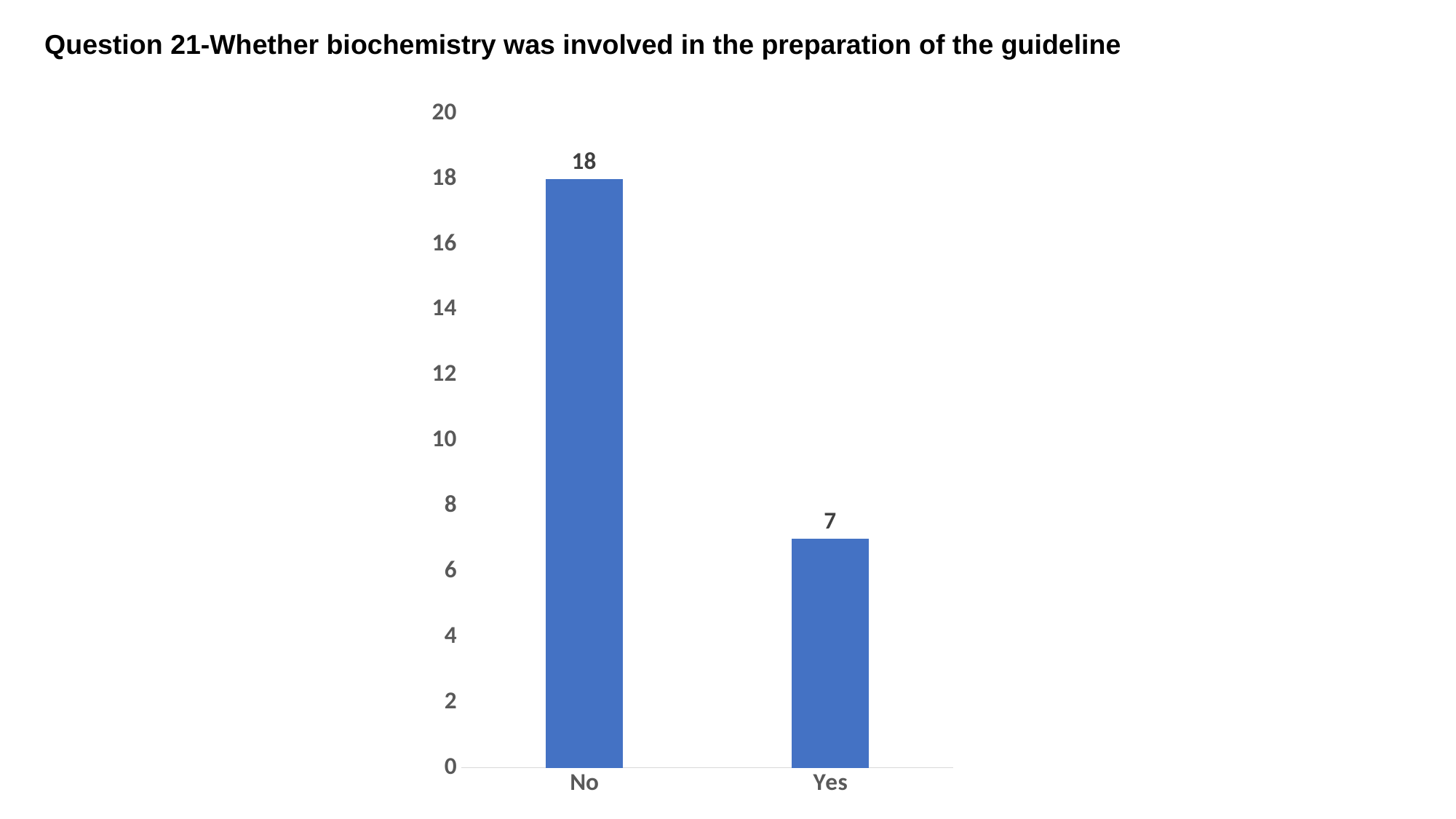
How many categories are shown on the x axis? 2 What is the title of the chart? Question 21-Whether biochemistry was involved in the preparation of the guideline Is the value for "Yes" greater or less than 10? less Which is larger, the value for "No" or the value for "Yes"? No What kind of chart is shown on the slide? bar chart Which category has the highest value? No Is the value for "No" greater or less than 16? greater What is the total of the two bars combined? 25 What is the value for the "Yes" category? 7 Which category has the lowest value? Yes What is the value for the "No" category? 18 What is the difference between the values for "No" and "Yes"? 11